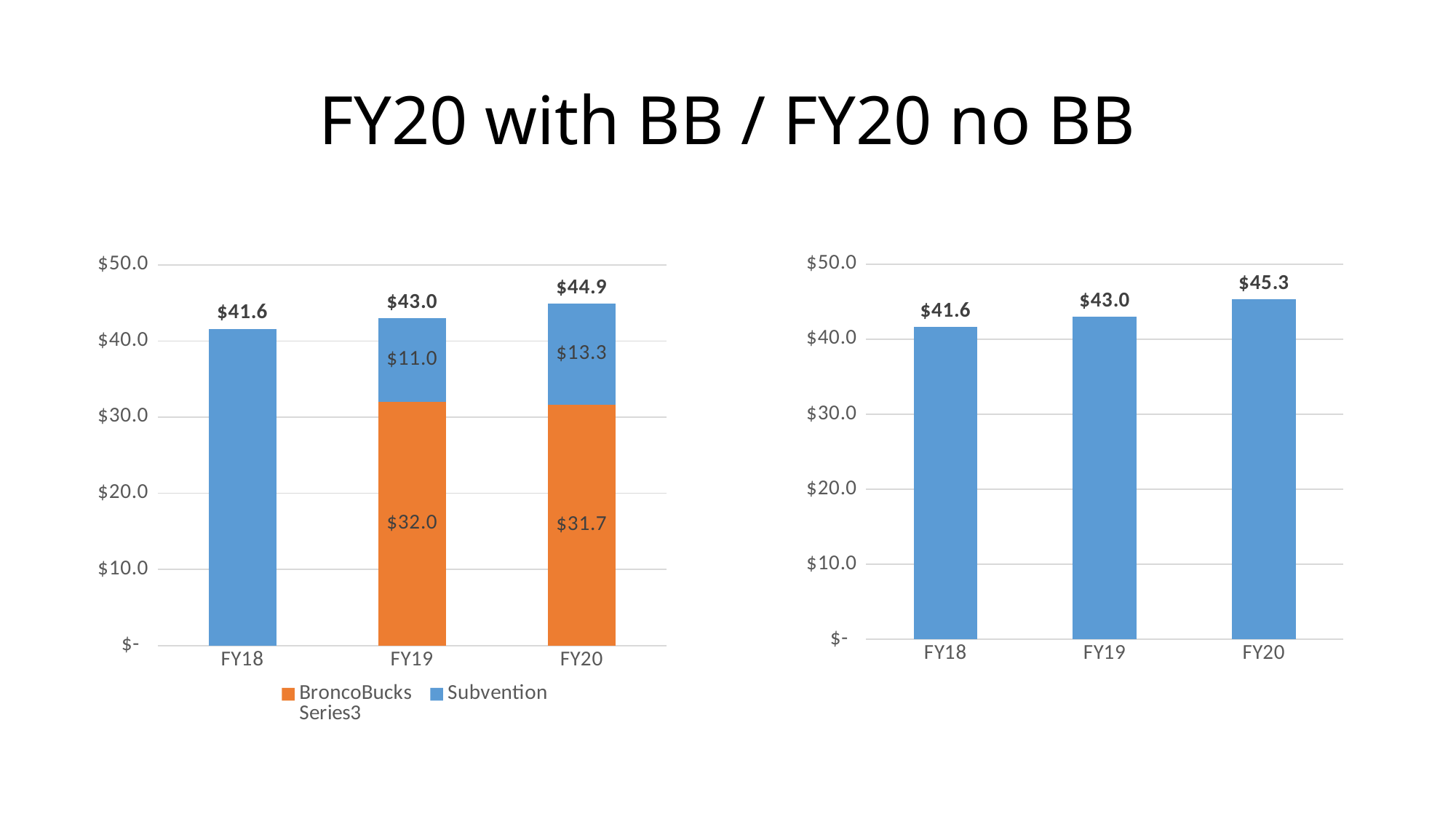
In the right chart, which fiscal year has the lowest value? FY18 In the left chart, what is the Subvention value for FY20? $13.3 In the left chart, which is larger for FY20: the BroncoBucks value or the Subvention value? BroncoBucks In the right chart, which fiscal year has the highest value? FY20 In the right chart, what is the difference between the FY20 and FY18 values? $3.7 How many entries does the legend of the left chart list? 3 What kind of chart is the right chart? Bar chart In the left chart, what is the difference between the BroncoBucks values for FY19 and FY20? $0.3 In the left chart, what is the total labelled above the FY20 stacked bar? $44.9 In the right chart, what is the value for FY20? $45.3 In the right chart, do the values rise or fall from FY18 to FY20? Rise In the left chart, what is the BroncoBucks value for FY19? $32.0